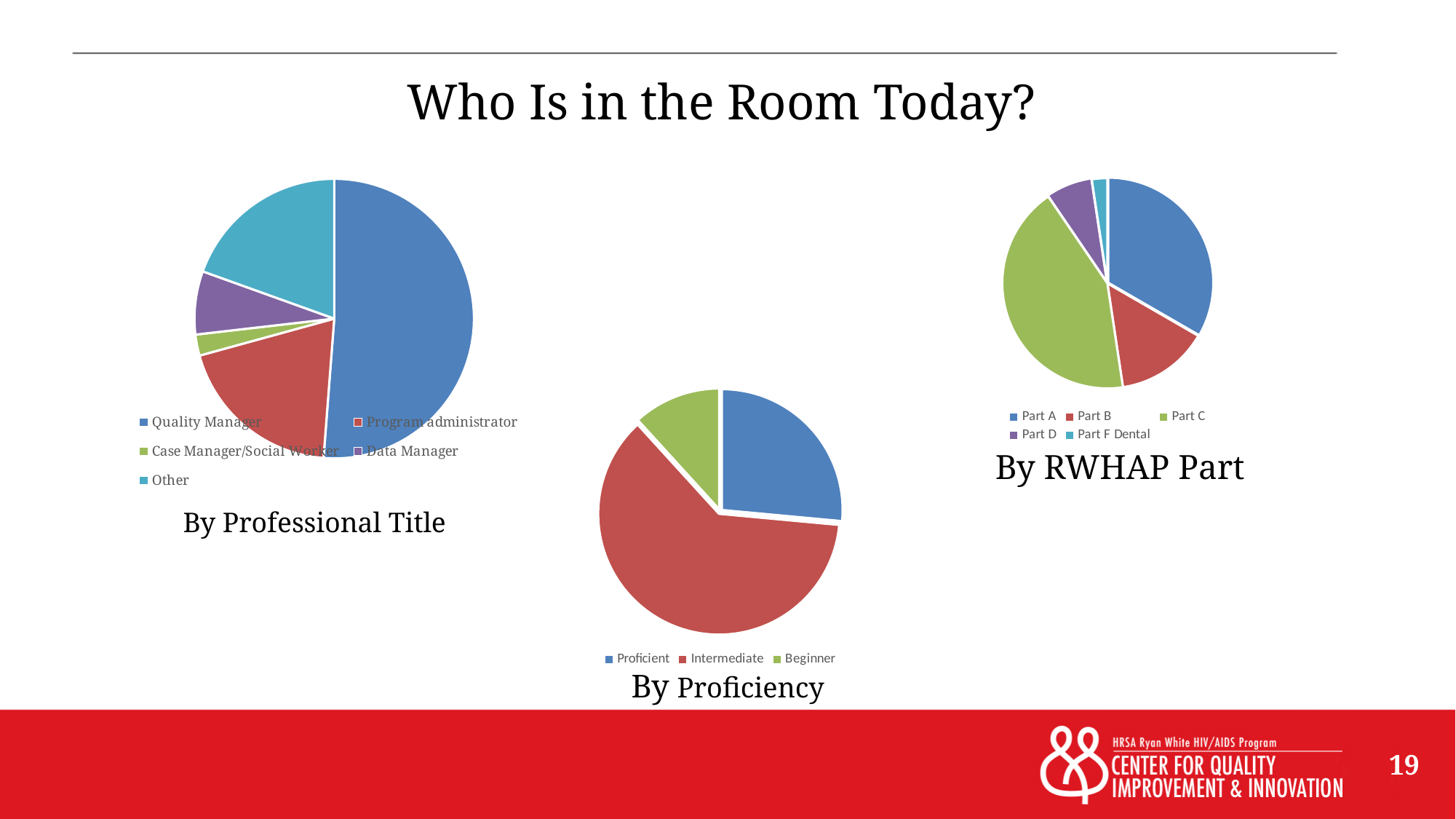
In the 'By Professional Title' chart, which category has the smallest slice? Case Manager/Social Worker In the 'By RWHAP Part' chart, which category has the largest slice? Part C In the 'By Professional Title' chart, which slice is larger: Program administrator or Data Manager? Program administrator How many categories does the legend of the 'By Proficiency' chart list? 3 In the 'By RWHAP Part' chart, which slice is larger: Part A or Part B? Part A How many pie charts are shown on the slide? 3 In the 'By Professional Title' chart, which category has the largest slice? Quality Manager In the 'By Proficiency' chart, which category has the largest slice? Intermediate How many categories does the legend of the 'By Professional Title' chart list? 5 In the 'By RWHAP Part' chart, which category has the smallest slice? Part F Dental What kind of chart is the 'By Professional Title' chart? Pie chart In the 'By Proficiency' chart, which category has the smallest slice? Beginner